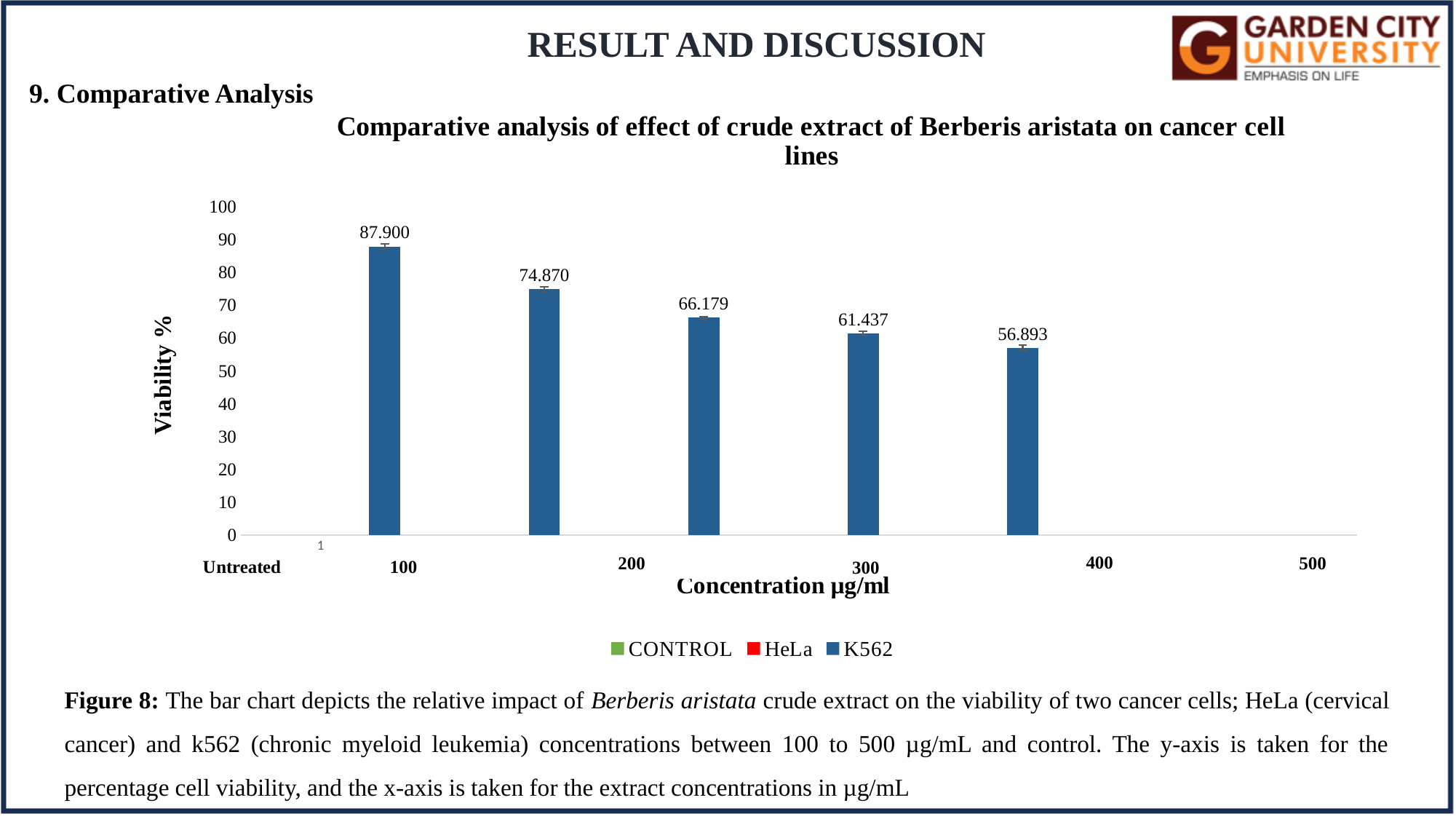
How many series does the legend list? 3 Which series in the legend is shown in blue? K562 What is the value shown on the middle (third) bar? 66.179 What is the difference between the leftmost bar (87.900) and the rightmost bar (56.893)? 31.007 How many bars are plotted in the chart? 5 What is the highest value labelled on any bar in the chart? 87.900 What is the value shown on the second bar from the left? 74.870 Do the bar values rise or fall from left to right across the chart? fall What is the value shown on the leftmost bar? 87.900 What is the value shown on the rightmost bar? 56.893 What is the lowest value labelled on any bar in the chart? 56.893 What type of chart is shown on the slide? bar chart